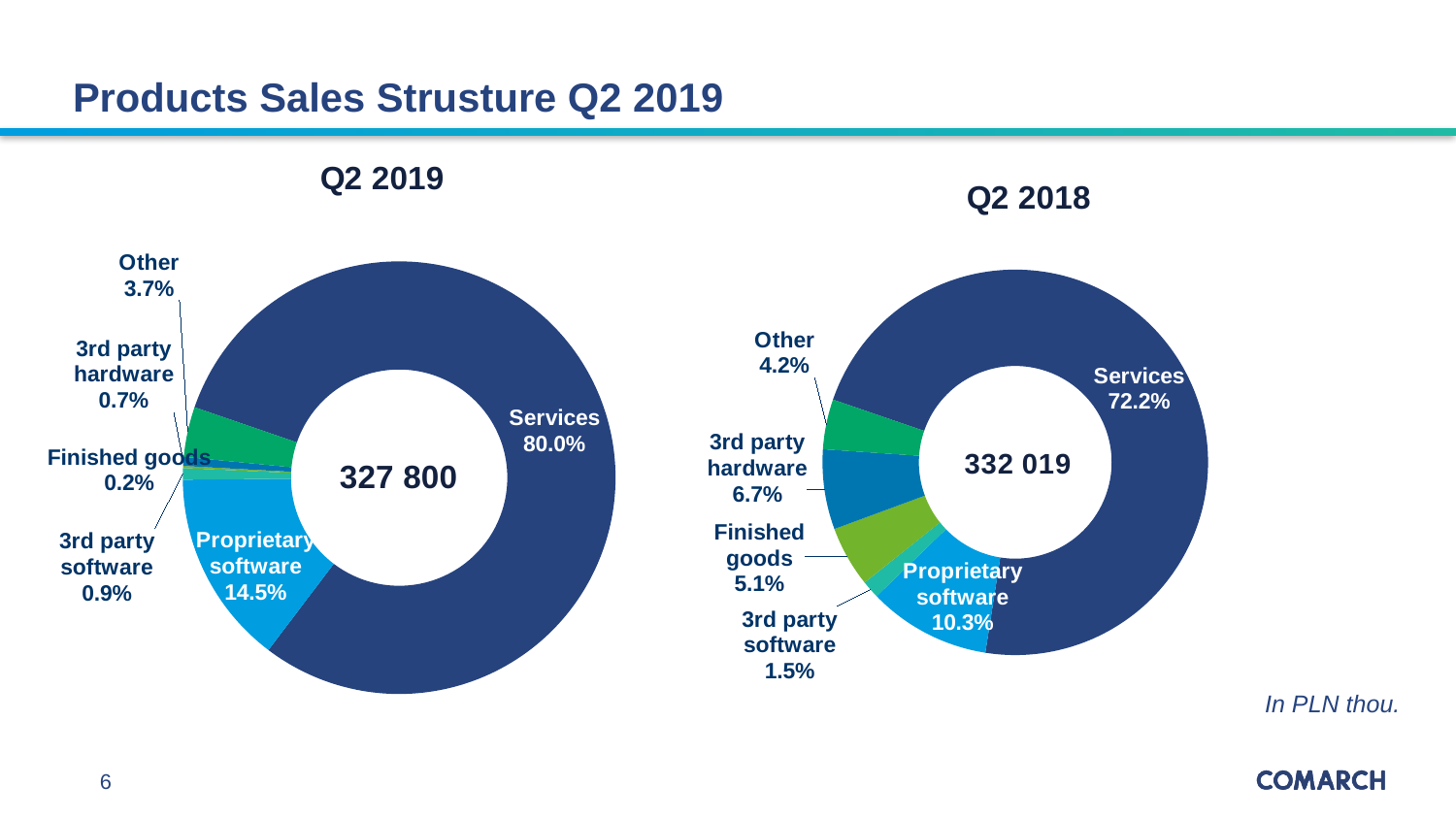
In the Q2 2018 chart, what share of sales does Proprietary software account for? 10.3% In the Q2 2019 chart, which category has the smallest share? Finished goods What unit is stated for the values on the slide? PLN thou. How many categories are shown in the Q2 2019 chart? 6 In the Q2 2018 chart, what is the share of Finished goods? 5.1% Which is larger: the 3rd party hardware share in the Q2 2018 chart or the 3rd party hardware share in the Q2 2019 chart? Q2 2018 In the Q2 2019 chart, what is the total value shown in the centre of the donut? 327 800 What kind of chart is used for Q2 2018? Donut (pie) chart In the Q2 2018 chart, which category has the largest share? Services What is the difference between the Services share in the Q2 2019 chart and the Services share in the Q2 2018 chart? 7.8 percentage points In the Q2 2018 chart, what is the total value shown in the centre of the donut? 332 019 In the Q2 2019 chart, what share of sales do Services account for? 80.0%